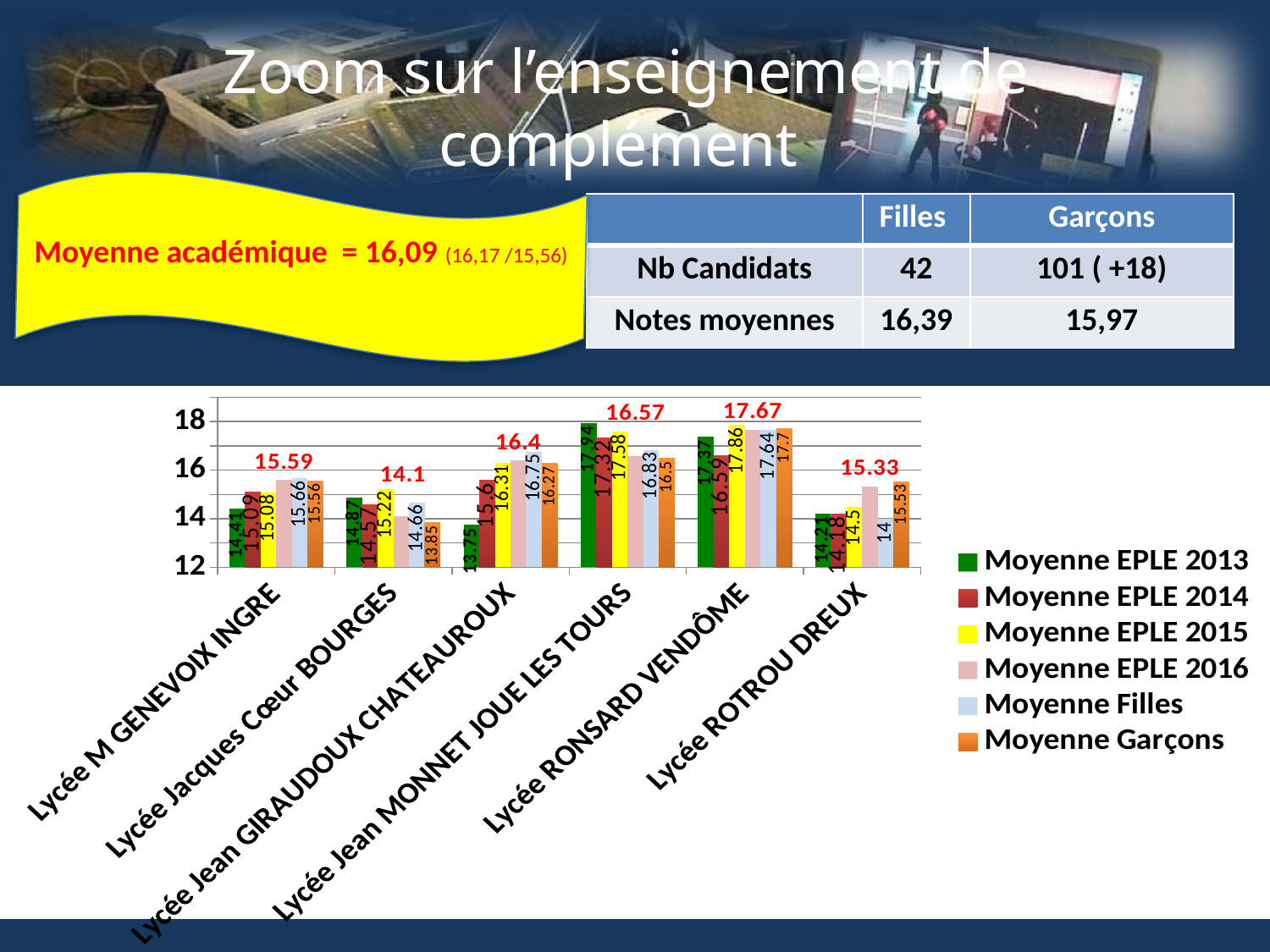
Which lycée has the lowest Moyenne Garçons value? Lycée Jacques Cœur BOURGES How many series does the chart legend list? 6 Which lycée has the highest Moyenne Garçons value? Lycée RONSARD VENDÔME For Lycée Jacques Cœur BOURGES, which is larger: Moyenne Filles or Moyenne Garçons? Moyenne Filles What is the difference between the Moyenne Filles (16.83) and Moyenne Garçons (16.5) values for Lycée Jean MONNET JOUE LES TOURS? 0.33 What is the Moyenne Filles value for Lycée Jean MONNET JOUE LES TOURS? 16.83 How many lycées (categories) are shown on the x axis of the chart? 6 What colour represents Moyenne Garçons in the chart legend? orange What is the red-labelled value shown above the group for Lycée Jean GIRAUDOUX CHATEAUROUX? 16.4 What kind of chart is shown on the slide? bar chart What is the Moyenne Garçons value for Lycée RONSARD VENDÔME? 17.7 Is the Moyenne EPLE 2013 value for Lycée Jean MONNET JOUE LES TOURS greater or less than 16? greater